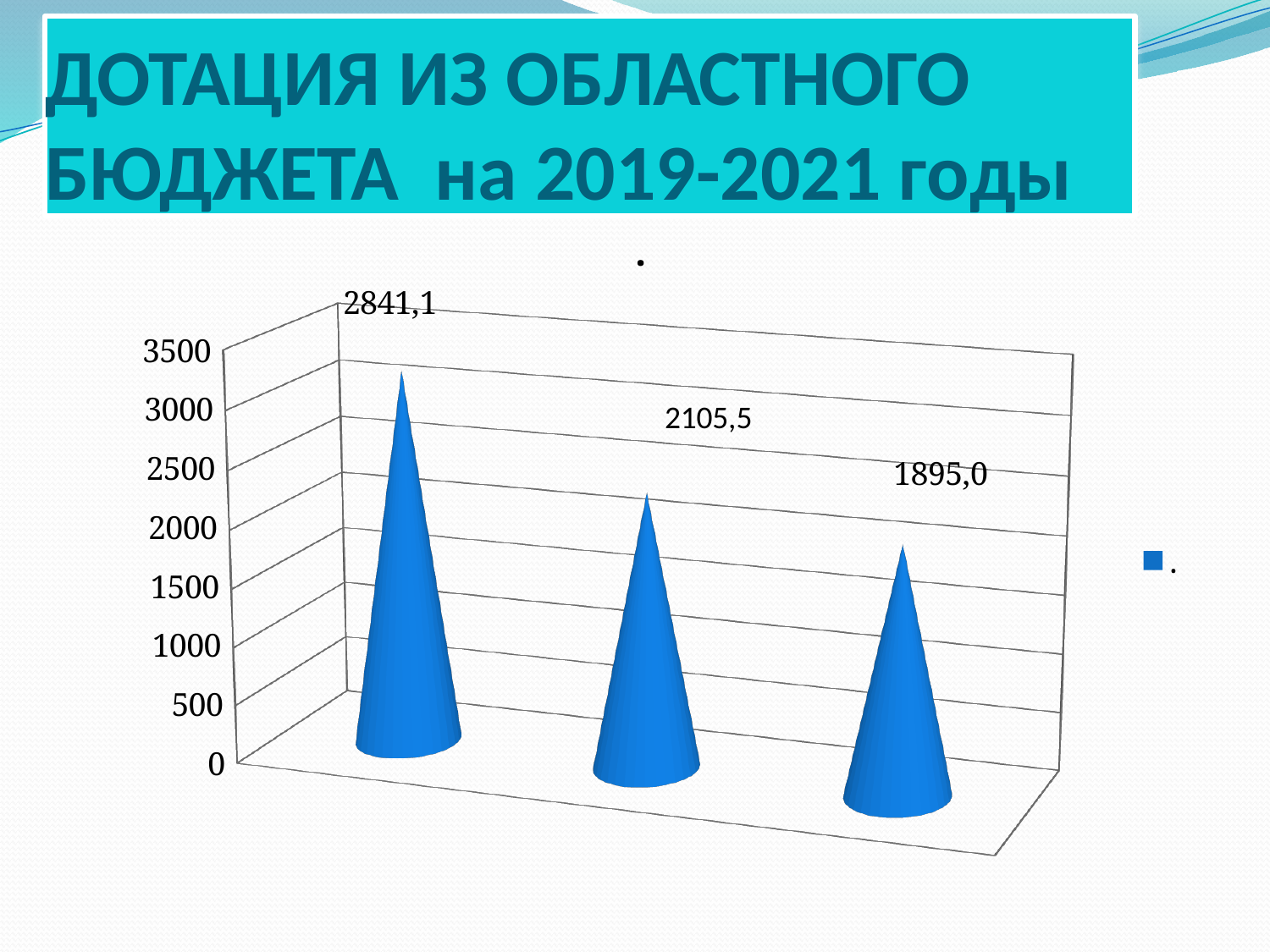
Do the values rise or fall from left to right across the chart? fall Which is larger, the value of the middle bar or the value of the rightmost bar? middle bar Is the value of the leftmost bar greater or less than 2500? greater What is the difference between the middle bar's value and the rightmost bar's value? 210,5 Which bar has the lowest value: the leftmost, middle, or rightmost? rightmost What kind of chart is shown on the slide? bar chart What is the value shown on the data label of the leftmost bar? 2841,1 What is the value shown on the data label of the rightmost bar? 1895,0 How many bars are plotted on the chart? 3 Which bar has the highest value: the leftmost, middle, or rightmost? leftmost What is the value shown on the data label of the middle bar? 2105,5 What is the difference between the leftmost bar's value and the middle bar's value? 735,6